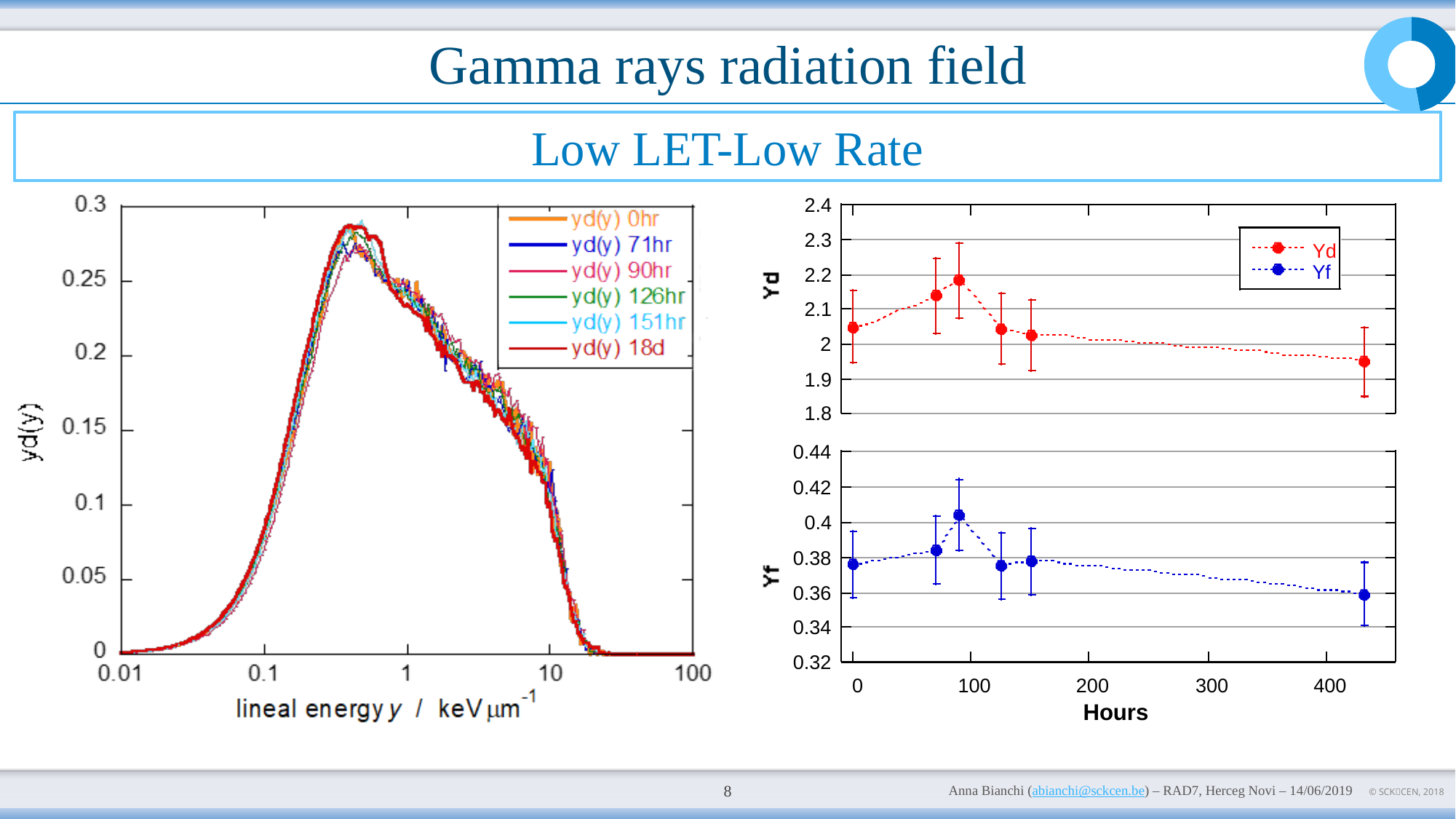
In the right chart, is the Yf value at around 90 hours greater or less than 0.38? greater How many series does the legend of the right chart list? 2 How many series does the legend of the left chart list? 6 In the right chart, does Yd rise or fall between about 90 hours and about 430 hours? fall On the left chart, do the yd(y) curves rise or fall as lineal energy increases from 1 to 10 keV µm⁻¹? fall In the right chart, is the Yd value at 0 hours greater or less than 2? greater In the right chart, is the Yd value at the last point (around 430 hours) greater or less than 2? less How many data points are plotted for the Yd series in the right chart? 6 What kind of chart is the left chart of yd(y) versus lineal energy? line chart What is the x-axis label of the right chart? Hours